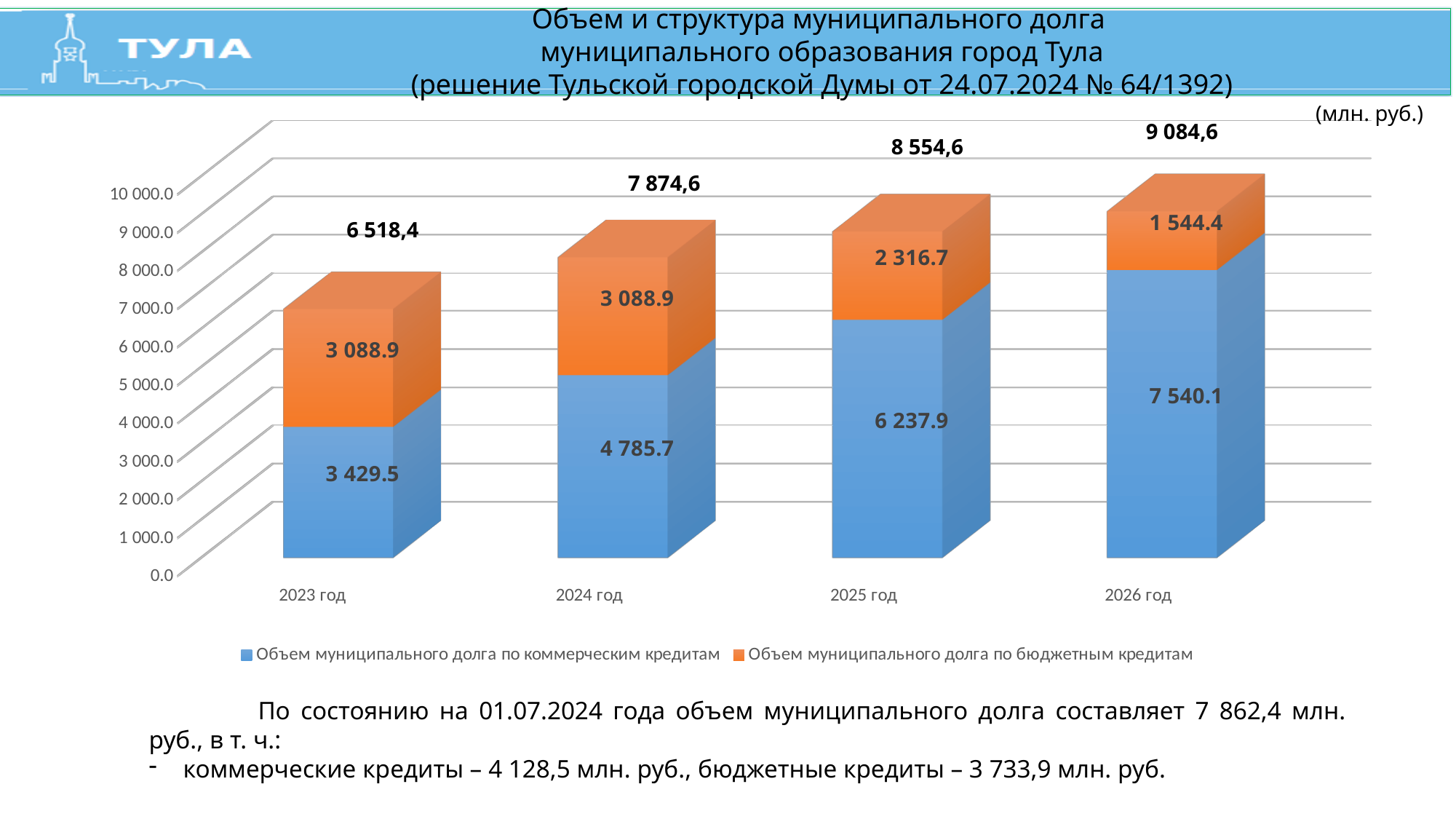
Which colour represents municipal debt on budget credits in the chart? Orange How many years (categories) are shown on the x axis of the chart? 4 What is the difference between the commercial credit debt in 2026 год and in 2023 год? 4 110.6 Which is larger in 2023 год: the debt on commercial credits or the debt on budget credits? Debt on commercial credits (3 429.5) Which year has the lowest value for municipal debt on budget credits? 2026 год Does the total municipal debt rise or fall from 2023 год to 2026 год? Rises What is the value of municipal debt on budget credits (Объем муниципального долга по бюджетным кредитам) for 2025 год? 2 316.7 What kind of chart is shown on the slide? Stacked bar chart How many series does the legend list? 2 What is the value of municipal debt on commercial credits (Объем муниципального долга по коммерческим кредитам) for 2024 год? 4 785.7 Which year has the highest value for municipal debt on commercial credits? 2026 год What is the total municipal debt shown above the bar for 2026 год? 9 084,6